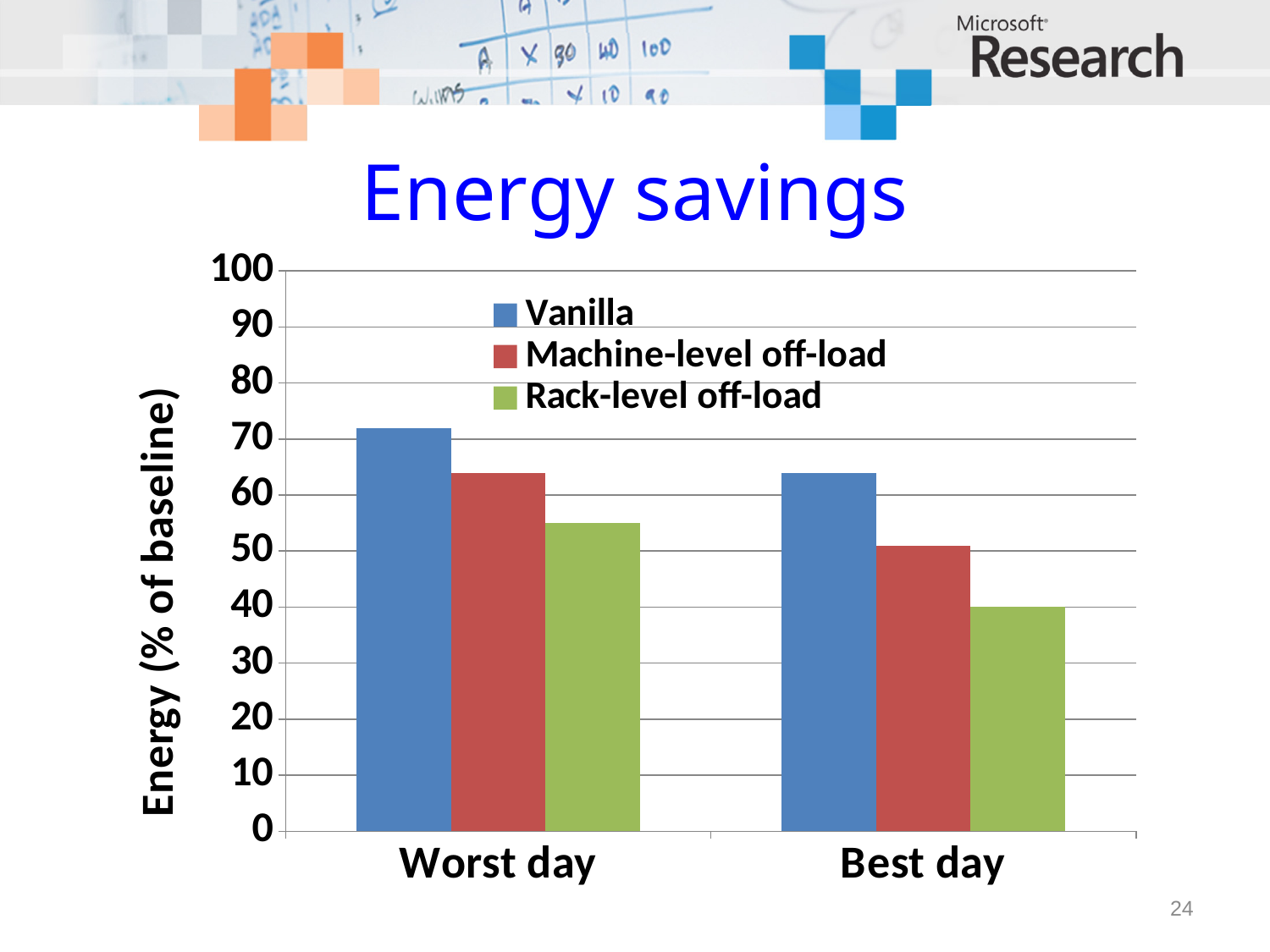
How many categories are shown on the x axis? 2 What is the label on the y axis? Energy (% of baseline) Is the Vanilla value for Worst day greater or less than 70? greater Is the Rack-level off-load value for Worst day greater or less than 50? greater Which series has the highest value for Worst day? Vanilla What is the title of the chart? Energy savings Is the Machine-level off-load value for Best day greater or less than 60? less Which series has the lowest value for Best day? Rack-level off-load Which is larger: the Vanilla value for Best day or the Machine-level off-load value for Best day? Vanilla value for Best day What kind of chart is shown on the slide? bar chart How many series does the legend list? 3 Does the Rack-level off-load value rise or fall from Worst day to Best day? fall